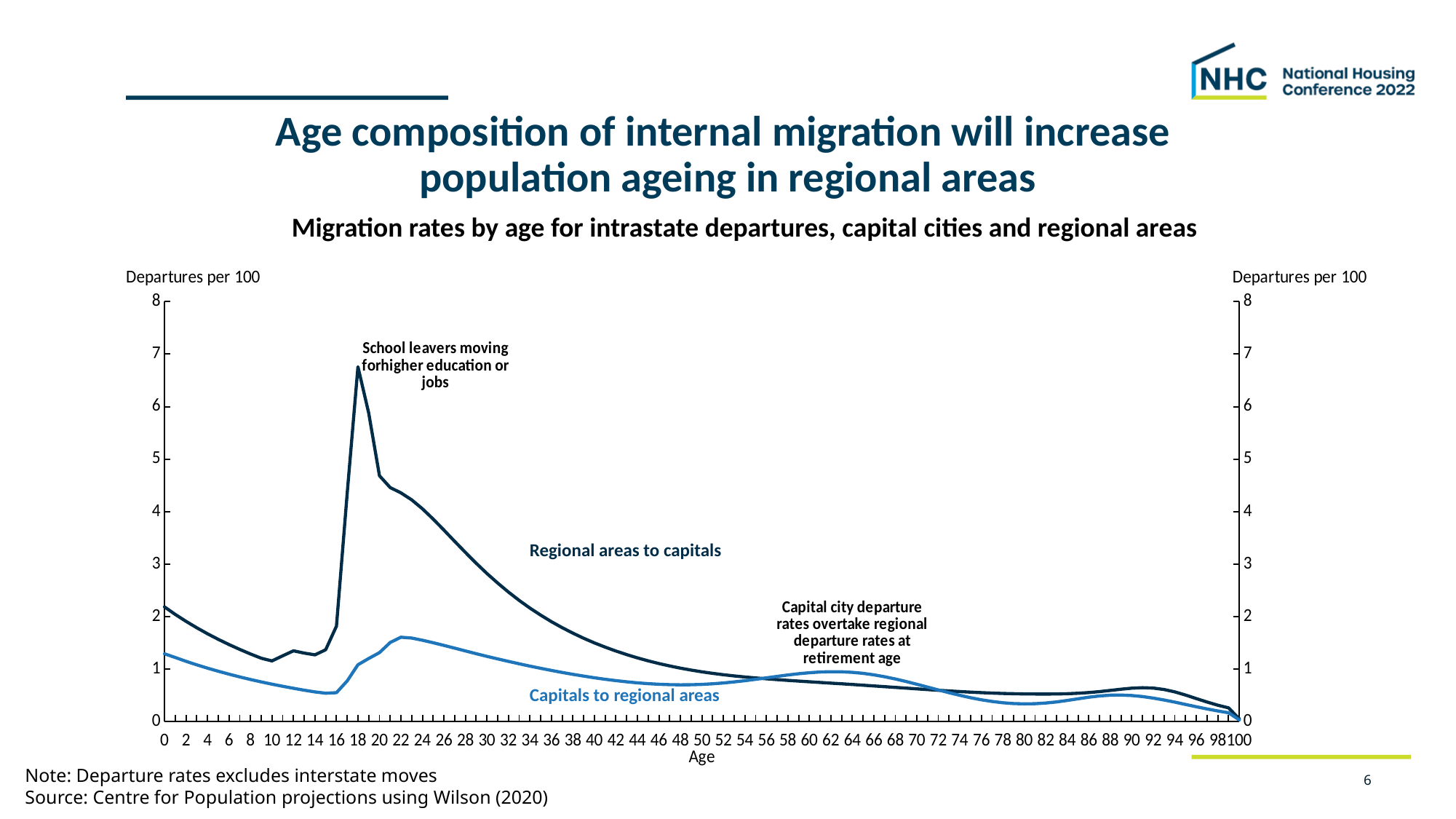
How many series are plotted on the chart? 2 Between age 18 and age 50, does the 'Regional areas to capitals' series rise or fall? fall What is the title of the chart? Migration rates by age for intrastate departures, capital cities and regional areas What kind of chart is shown on the slide? Line chart What is the label on the vertical axis of the chart? Departures per 100 Is the value for 'Regional areas to capitals' at age 18 greater or less than 6? greater Is the value for 'Capitals to regional areas' at age 80 greater or less than 1? less At age 18, which series has the higher value, 'Regional areas to capitals' or 'Capitals to regional areas'? Regional areas to capitals At age 62, which series has the higher value, 'Regional areas to capitals' or 'Capitals to regional areas'? Capitals to regional areas Is the value for 'Regional areas to capitals' at age 0 greater or less than 2? greater At what age does the 'Regional areas to capitals' series reach its highest value? 18